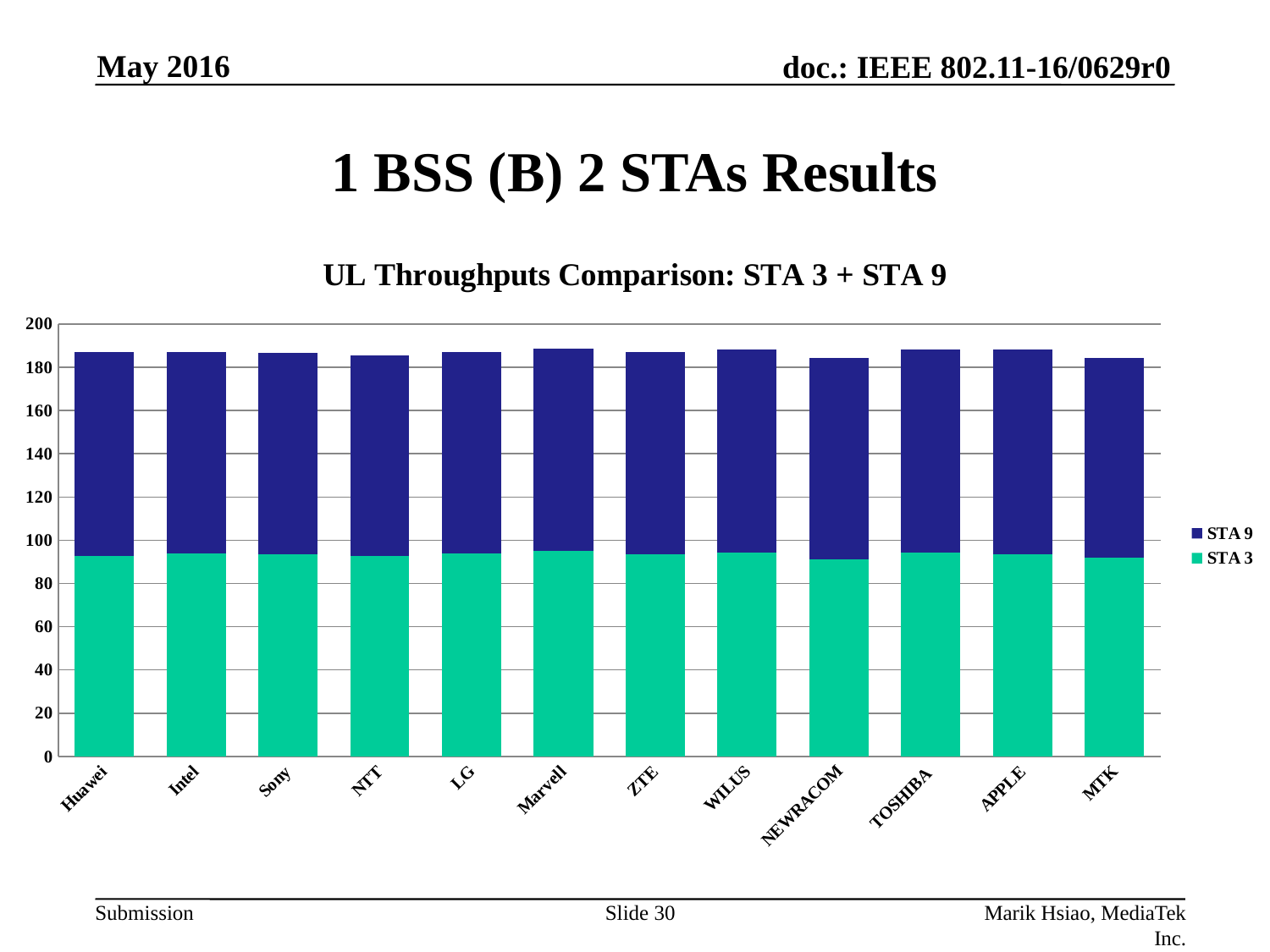
Which category appears first on the x axis? Huawei Is the total stacked bar height for Marvell greater or less than 180? greater Is the STA 3 value for Intel greater or less than 100? less Is the STA 3 value for NEWRACOM greater or less than 60? greater How many series does the legend list? 2 Which series are listed in the legend? STA 9 and STA 3 How many companies (categories) are shown on the x axis? 12 What kind of chart is shown on the slide? stacked bar chart What is the title of the chart? UL Throughputs Comparison: STA 3 + STA 9